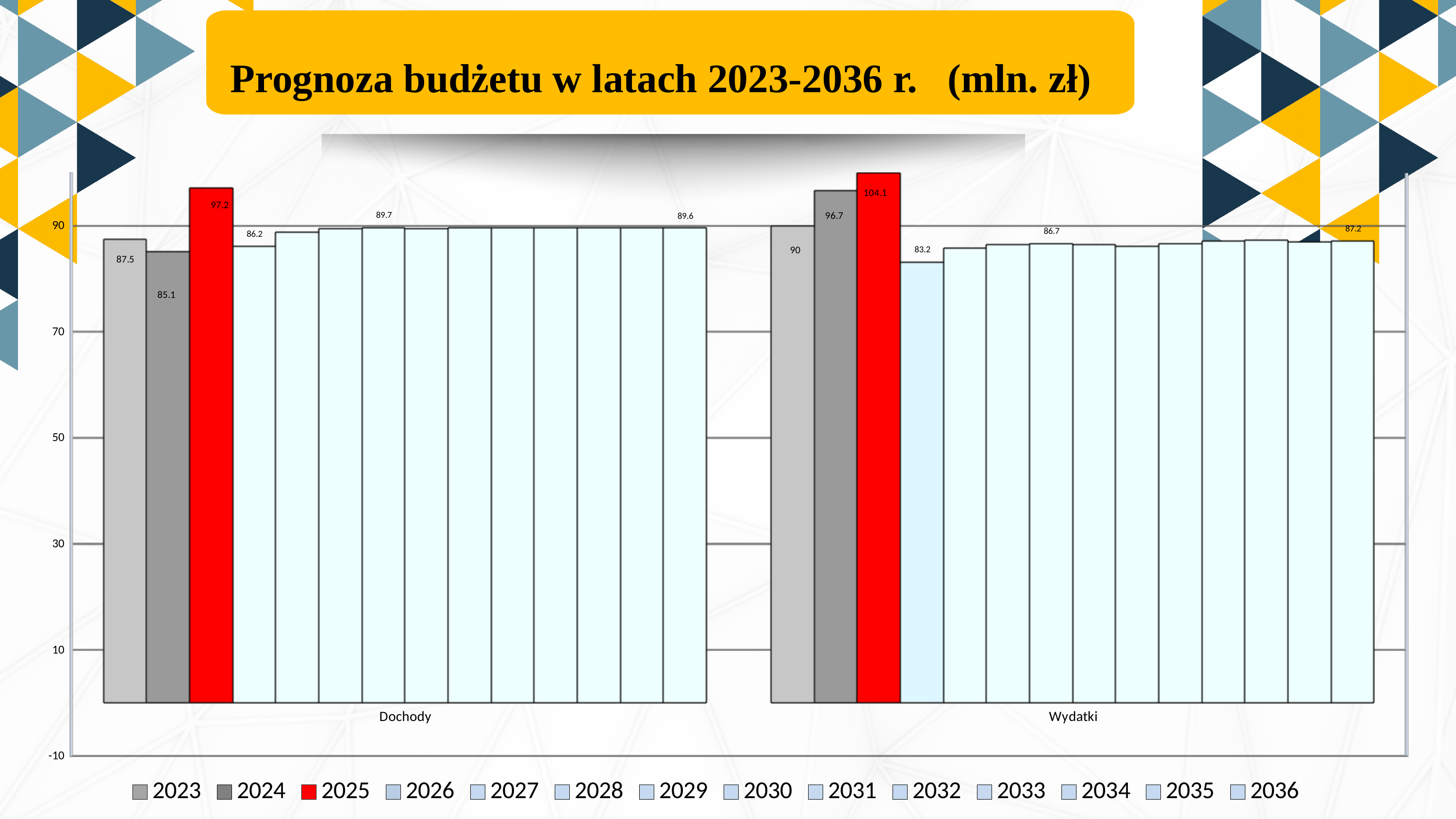
Which year has the lowest Wydatki value? 2026 What is the Wydatki value for 2023? 90 Which is larger, the Dochody value for 2023 or for 2024? 2023 What kind of chart is shown on the slide? bar chart What is the difference between the Wydatki and Dochody values for 2025? 6.9 Which year has the highest Wydatki value? 2025 How many series (years) does the legend list? 14 How many categories are shown on the x axis? 2 What is the Wydatki value for 2025? 104.1 What is the Dochody value for 2025? 97.2 What is the Dochody value for 2036? 89.6 What colour are the 2025 bars? red